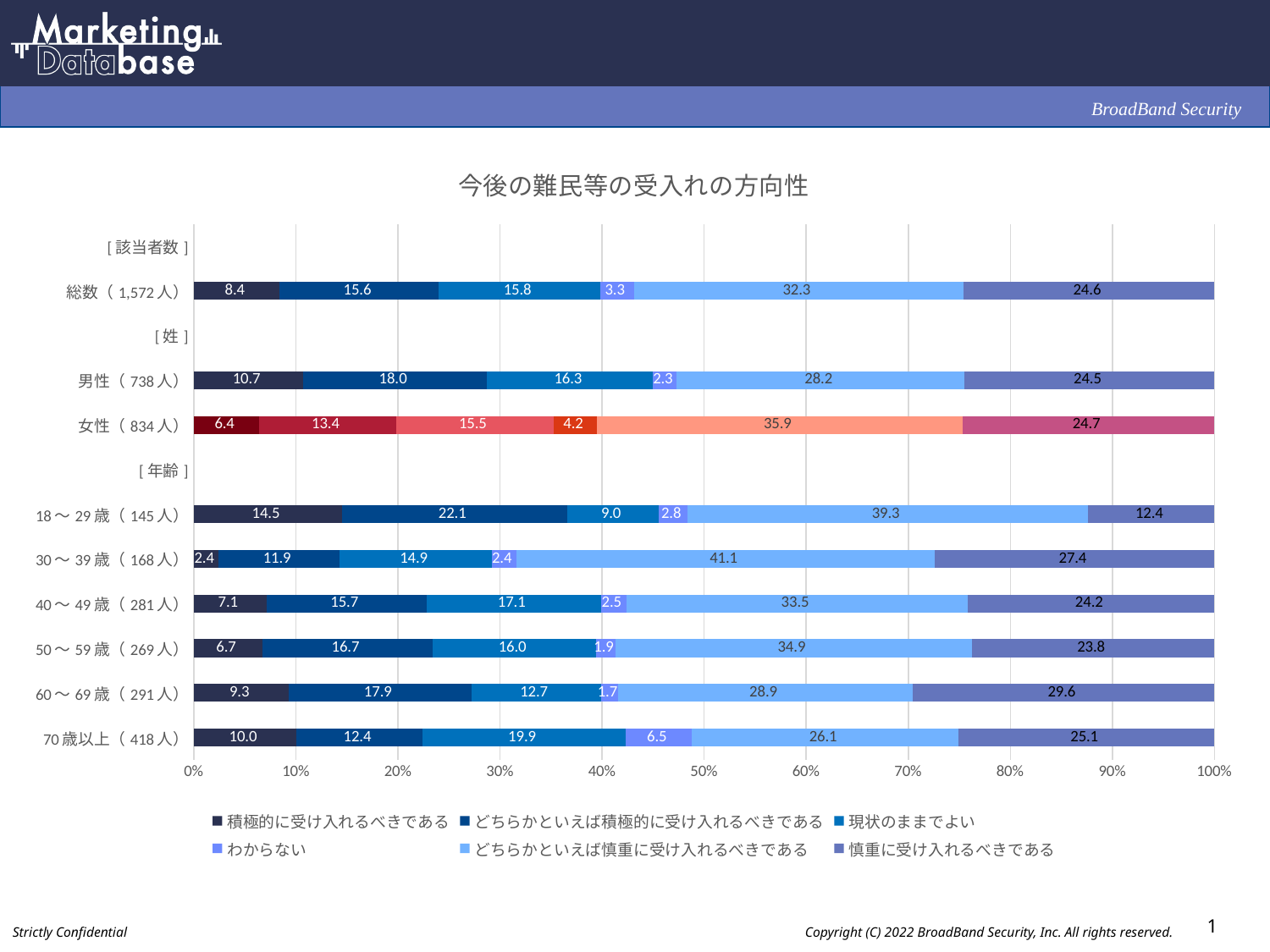
Which category has the highest value for どちらかといえば慎重に受け入れるべきである? 30～39歳 (168人) Which category has the highest value for 積極的に受け入れるべきである? 18～29歳 (145人) What is the difference between the 積極的に受け入れるべきである values for 男性 (738人) and 女性 (834人)? 4.3 How many series does the legend list? 6 What is the value for どちらかといえば慎重に受け入れるべきである for 女性 (834人)? 35.9 Which has the larger value for 慎重に受け入れるべきである, 60～69歳 (291人) or 70歳以上 (418人)? 60～69歳 (291人) What is the value for わからない for 70歳以上 (418人)? 6.5 What kind of chart is shown on the slide? Stacked bar chart What is the value for 積極的に受け入れるべきである for 総数 (1,572人)? 8.4 Which category has the lowest value for 積極的に受け入れるべきである? 30～39歳 (168人) What is the value for 慎重に受け入れるべきである for 18～29歳 (145人)? 12.4 How many categories have data bars plotted in the chart? 9